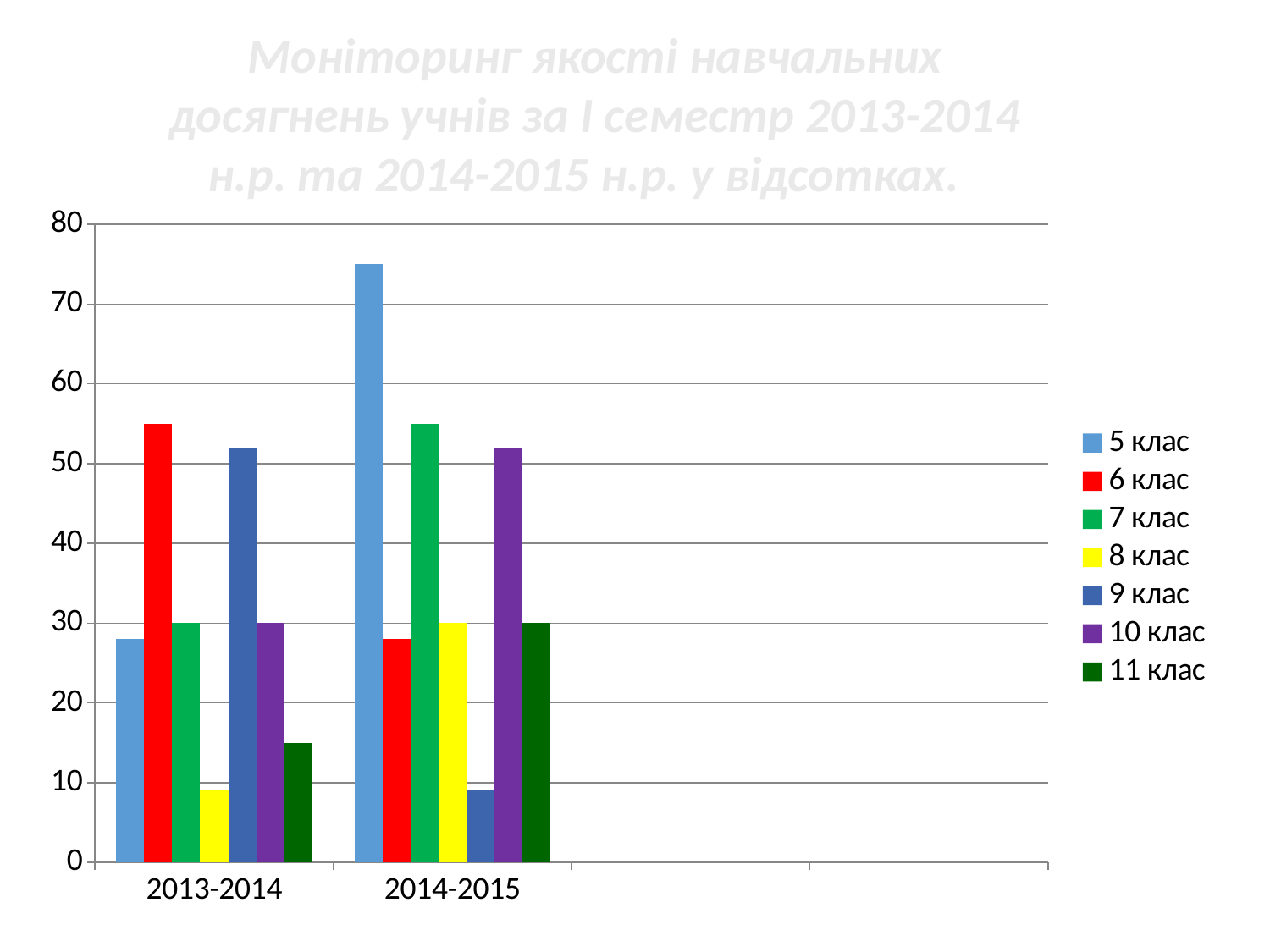
Is the value for 9 клас in 2014-2015 greater or less than 10? less How many series does the legend list? 7 Is the value for 5 клас in 2014-2015 greater or less than 70? greater Which is larger: the value for 6 клас in 2013-2014 or the value for 6 клас in 2014-2015? 2013-2014 What is the value for 7 клас in 2013-2014? 30 What is the value for 8 клас in 2014-2015? 30 What is the value for 11 клас in 2014-2015? 30 How many categories are shown on the x axis? 2 Which series has the highest value in 2014-2015? 5 клас Which series has the lowest value in 2014-2015? 9 клас Which series has the lowest value in 2013-2014? 8 клас What kind of chart is shown on the slide? bar chart